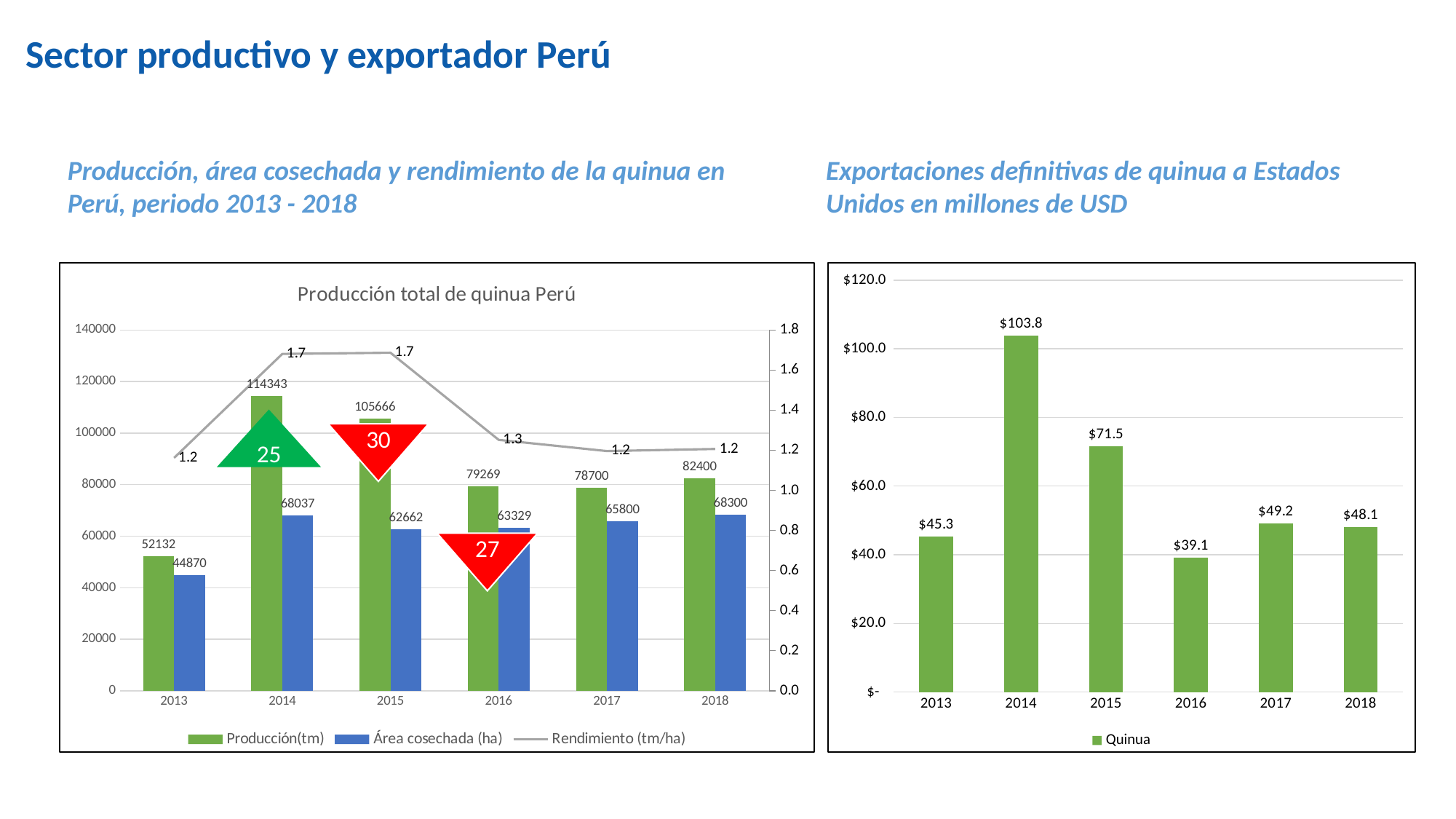
In the 'Producción total de quinua Perú' chart, what is the Producción(tm) value for 2014? 114343 In the 'Producción total de quinua Perú' chart, what is the Rendimiento (tm/ha) value for 2016? 1.3 In the 'Producción total de quinua Perú' chart, is Área cosechada (ha) larger in 2016 or in 2018? 2018 What kind of chart is the right-hand chart of exports to the United States? Bar chart In the right-hand chart of exports to the United States, how many years are shown on the x axis? 6 In the 'Producción total de quinua Perú' chart, what is the difference between Producción(tm) in 2014 and 2015? 8677 In the right-hand chart of exports to the United States, what is the difference between the 2015 and 2016 values? $32.4 In the 'Producción total de quinua Perú' chart, which year has the lowest Producción(tm)? 2013 In the right-hand chart of exports to the United States, what is the value for 2014? $103.8 In the 'Producción total de quinua Perú' chart, how many series does the legend list? 3 In the 'Producción total de quinua Perú' chart, what is the Área cosechada (ha) value for 2013? 44870 In the right-hand chart of exports to the United States, which year has the lowest value? 2016